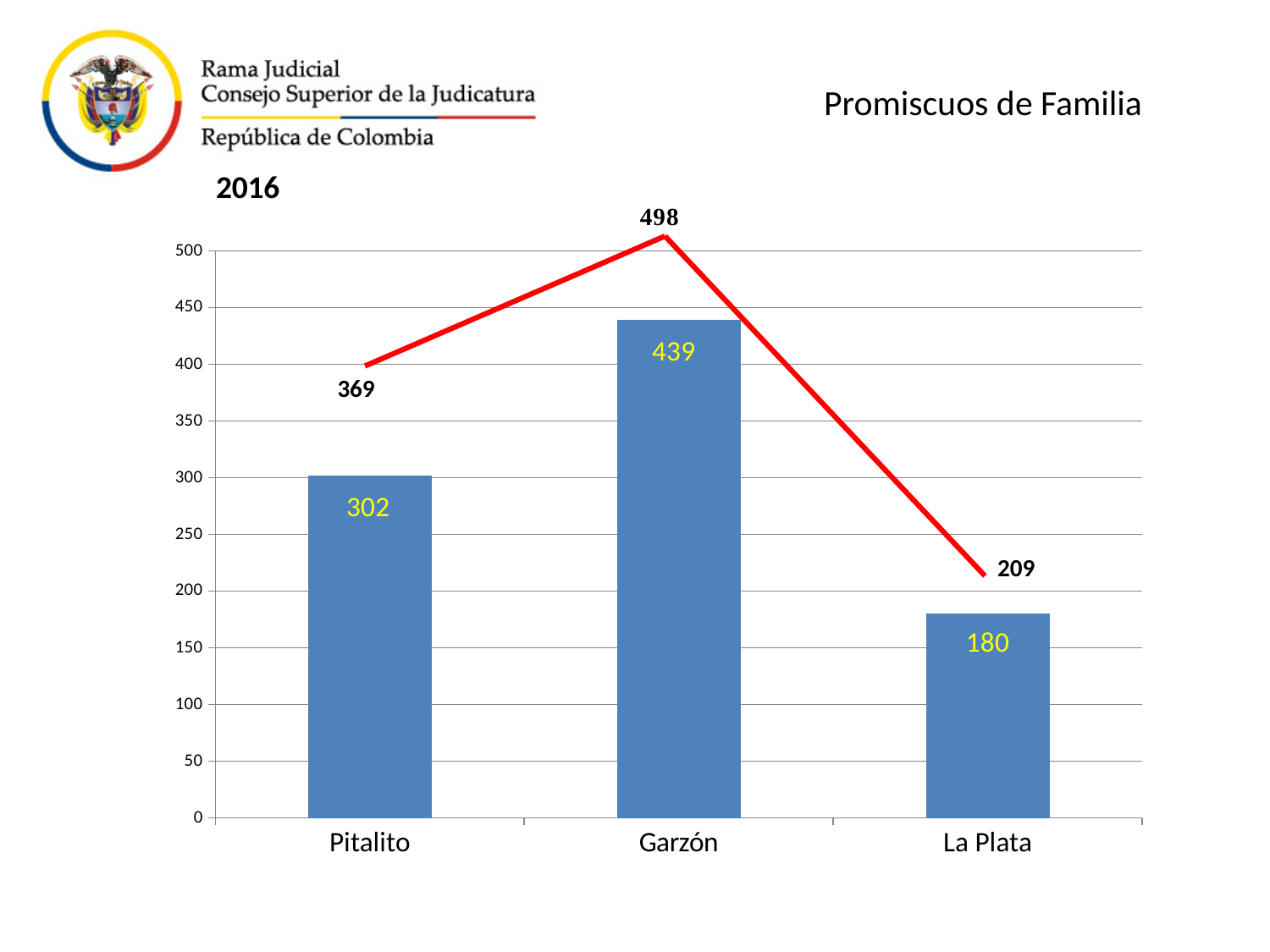
What value does the red line show for La Plata? 209 Which is larger, the bar value for Pitalito or the bar value for La Plata? Pitalito How many categories are shown on the x axis? 3 What is the bar value for Pitalito? 302 What is the difference between the red line value and the bar value for Pitalito? 67 What year is shown as the chart title? 2016 What is the bar value for La Plata? 180 What value does the red line show for Garzón? 498 What is the difference between the bar values for Garzón and Pitalito? 137 What is the bar value for Garzón? 439 Which category has the lowest bar? La Plata Which category has the highest bar? Garzón